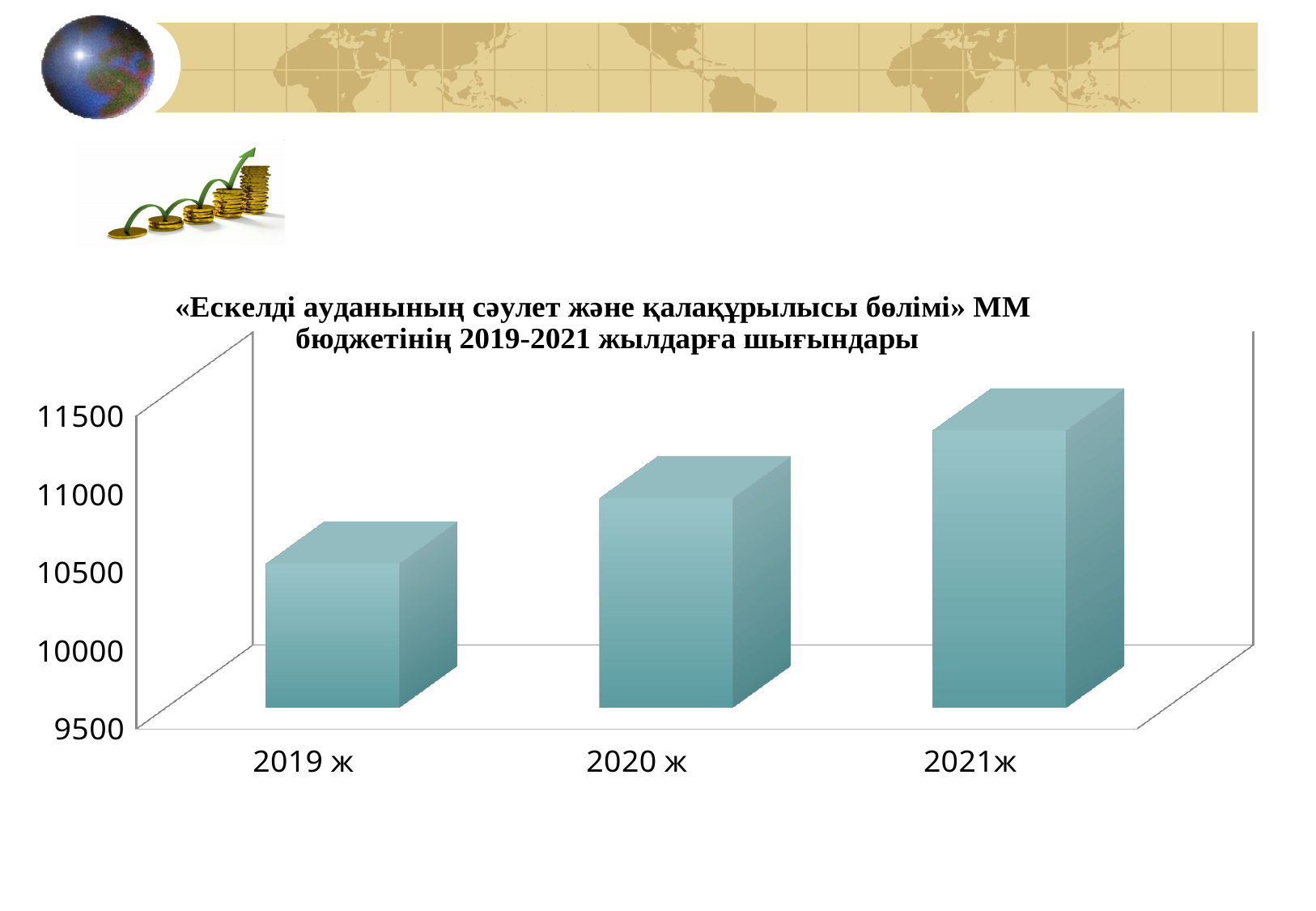
Is the value for 2020 ж greater or less than 10500? greater Is the value for 2019 ж greater or less than 11000? less Is the value for 2019 ж greater or less than 10000? greater Do the values rise or fall from 2019 ж to 2021ж? rise Which year has the highest value in the chart? 2021ж Which is larger, the value for 2020 ж or the value for 2019 ж? 2020 ж How many bars (categories) are plotted in the chart? 3 Which is larger, the value for 2021ж or the value for 2020 ж? 2021ж Which year has the lowest value in the chart? 2019 ж What is the lowest value shown on the vertical axis of the chart? 9500 What kind of chart is shown on the slide? bar chart